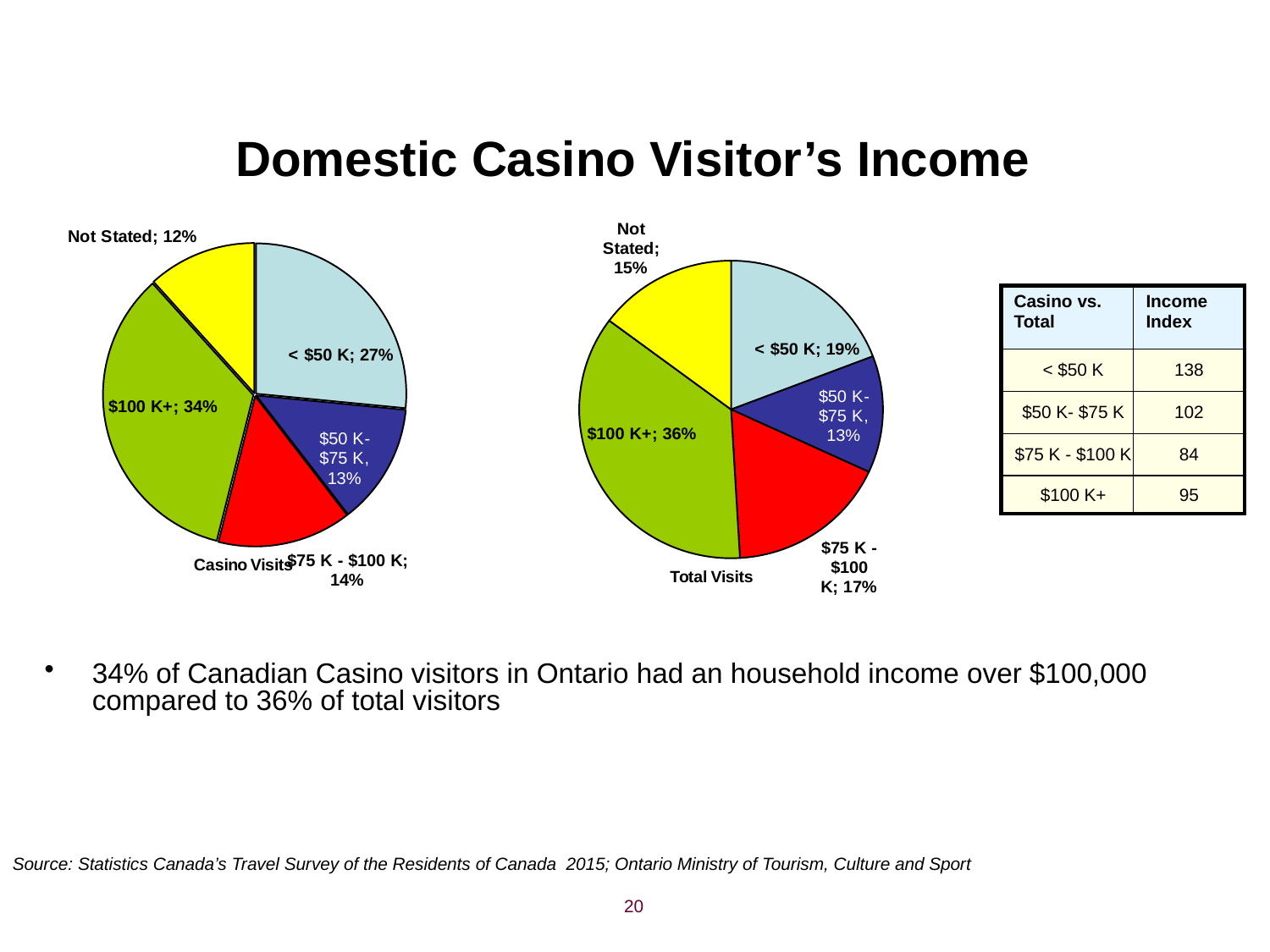
In the Casino Visits pie chart, which income category has the smallest slice? Not Stated In the Total Visits pie chart, which income category has the smallest slice? $50 K-$75 K In the Total Visits pie chart, what percentage is shown for $75 K - $100 K? 17% What is the difference between the < $50 K share in the Casino Visits chart and the < $50 K share in the Total Visits chart? 8 percentage points In the Total Visits pie chart, what share of visitors had a household income of $100 K+? 36% In the Total Visits pie chart, what percentage is shown for < $50 K? 19% In the Casino Visits pie chart, which income category has the largest slice? $100 K+ In the Casino Visits pie chart, what share of visitors had a household income of $100 K+? 34% What type of chart is used to show Total Visits by income? Pie chart How many slices does the Casino Visits pie chart have? 5 Which is larger: the Not Stated share in the Casino Visits chart or the Not Stated share in the Total Visits chart? Total Visits In the Casino Visits pie chart, what percentage is shown for < $50 K? 27%